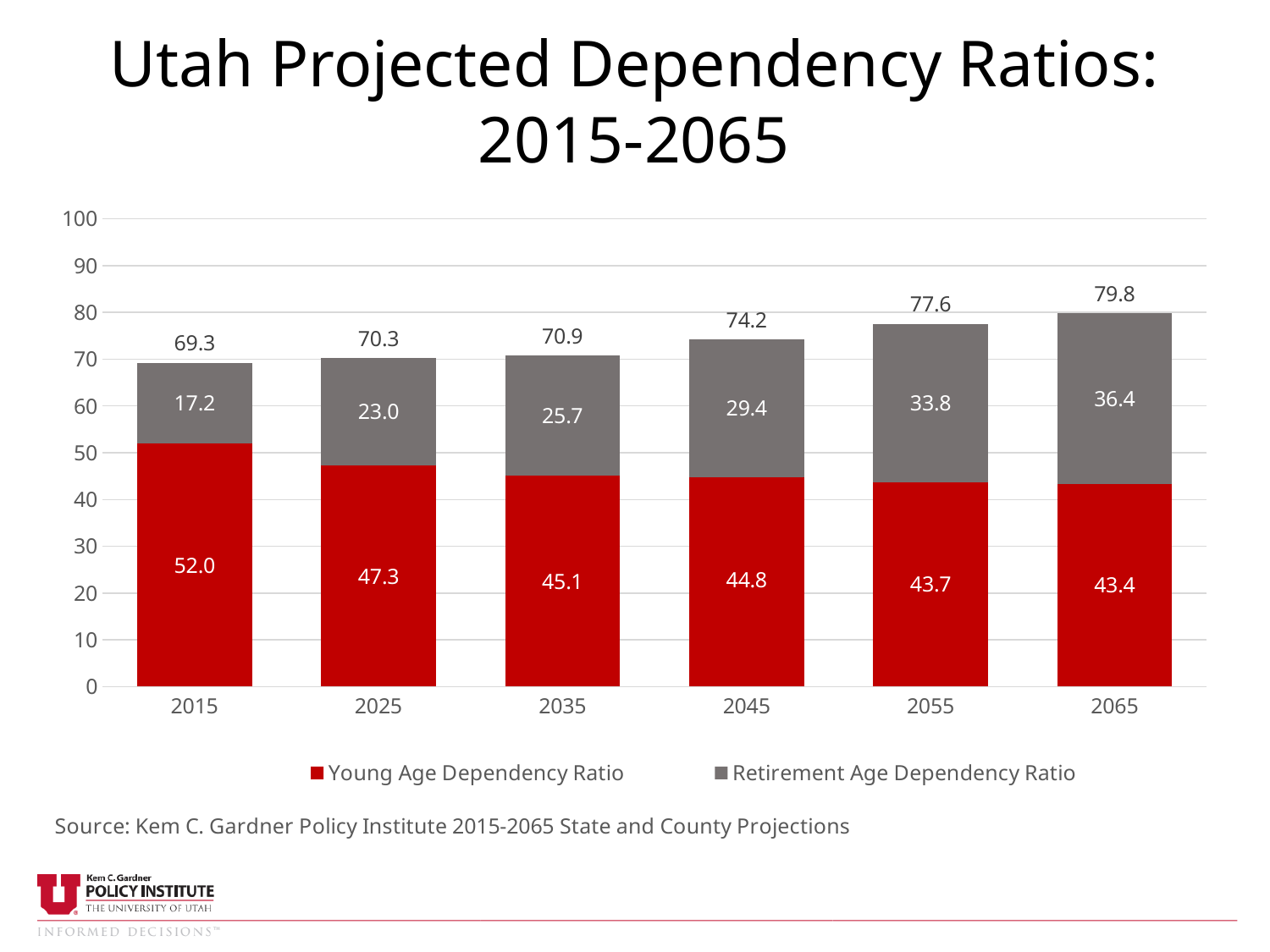
How many years are shown on the x axis? 6 What is the Young Age Dependency Ratio for 2015? 52.0 Is the total dependency ratio for 2025 greater or less than 80? less Does the Retirement Age Dependency Ratio rise or fall from 2015 to 2065? Rise Which year has the highest Retirement Age Dependency Ratio? 2065 What kind of chart is shown on the slide? Stacked bar chart How many series does the legend list? 2 What is the difference between the Young Age Dependency Ratio in 2015 and in 2065? 8.6 Which year has the lowest Young Age Dependency Ratio? 2065 Which is larger in 2055: the Young Age Dependency Ratio or the Retirement Age Dependency Ratio? Young Age Dependency Ratio What is the total dependency ratio shown above the bar for 2045? 74.2 What is the Retirement Age Dependency Ratio for 2065? 36.4